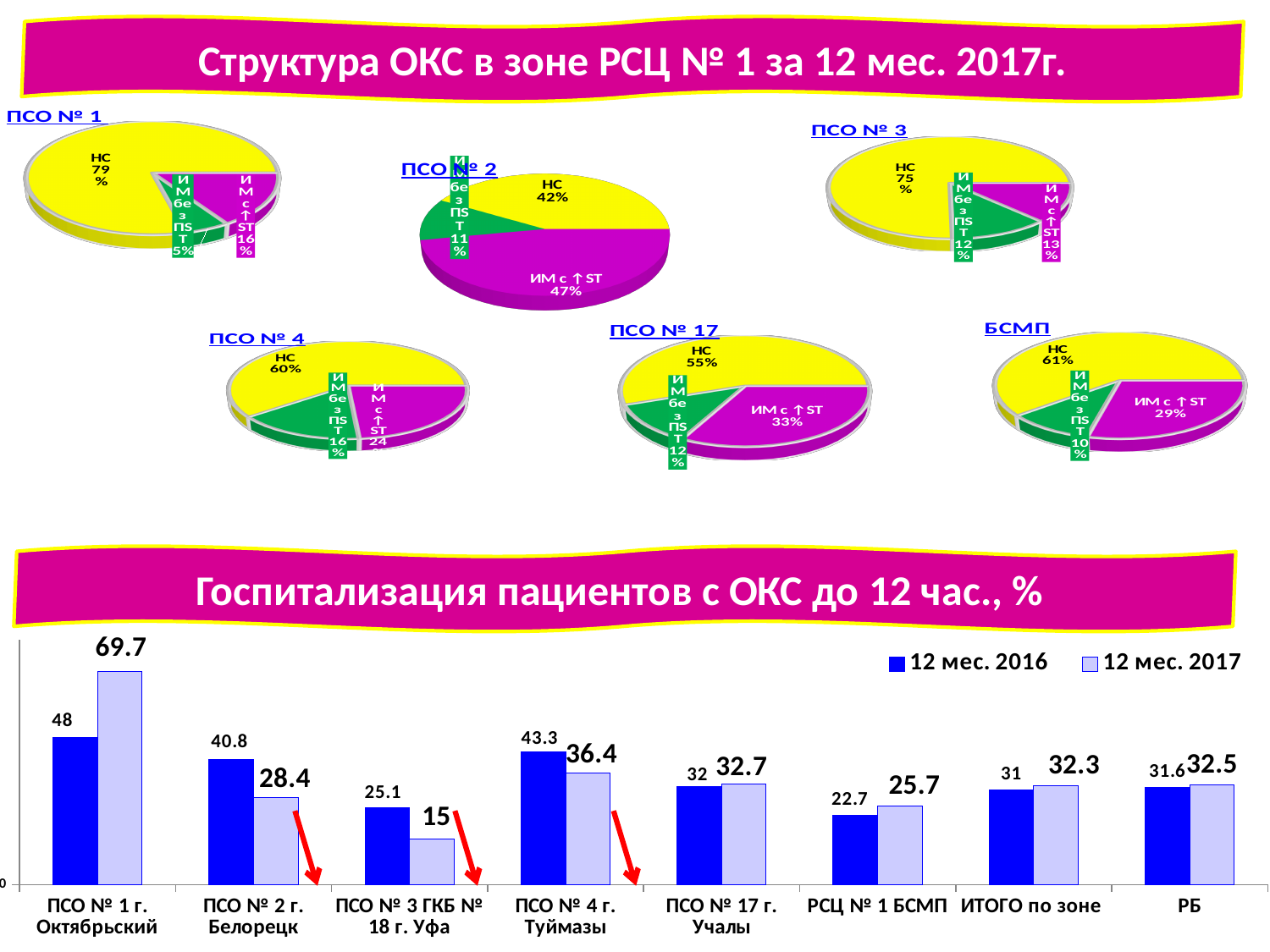
In the bar chart 'Госпитализация пациентов с ОКС до 12 час., %', which is larger for ПСО № 4 г. Туймазы: the '12 мес. 2016' value or the '12 мес. 2017' value? 12 мес. 2016 How many categories are shown on the x axis of the bar chart 'Госпитализация пациентов с ОКС до 12 час., %'? 8 How many series does the legend of the bar chart 'Госпитализация пациентов с ОКС до 12 час., %' list? 2 What kind of chart is the 'Госпитализация пациентов с ОКС до 12 час., %' chart? bar chart In the pie chart 'ПСО № 2', what share does the 'ИМ с ↑ST' slice have? 47% In the bar chart 'Госпитализация пациентов с ОКС до 12 час., %', what is the value for ПСО № 3 ГКБ № 18 г. Уфа in the '12 мес. 2016' series? 25.1 In the bar chart 'Госпитализация пациентов с ОКС до 12 час., %', what is the difference between the '12 мес. 2016' and '12 мес. 2017' values for ПСО № 2 г. Белорецк? 12.4 In the pie chart 'ПСО № 1', what share does the 'НС' slice have? 79% In the bar chart 'Госпитализация пациентов с ОКС до 12 час., %', what is the value for ПСО № 1 г. Октябрьский in the '12 мес. 2017' series? 69.7 In the bar chart 'Госпитализация пациентов с ОКС до 12 час., %', which category has the lowest value in the '12 мес. 2017' series? ПСО № 3 ГКБ № 18 г. Уфа In the pie chart 'БСМП', what share does the 'ИМ без ПST' slice have? 10% In the bar chart 'Госпитализация пациентов с ОКС до 12 час., %', which category has the highest value in the '12 мес. 2017' series? ПСО № 1 г. Октябрьский